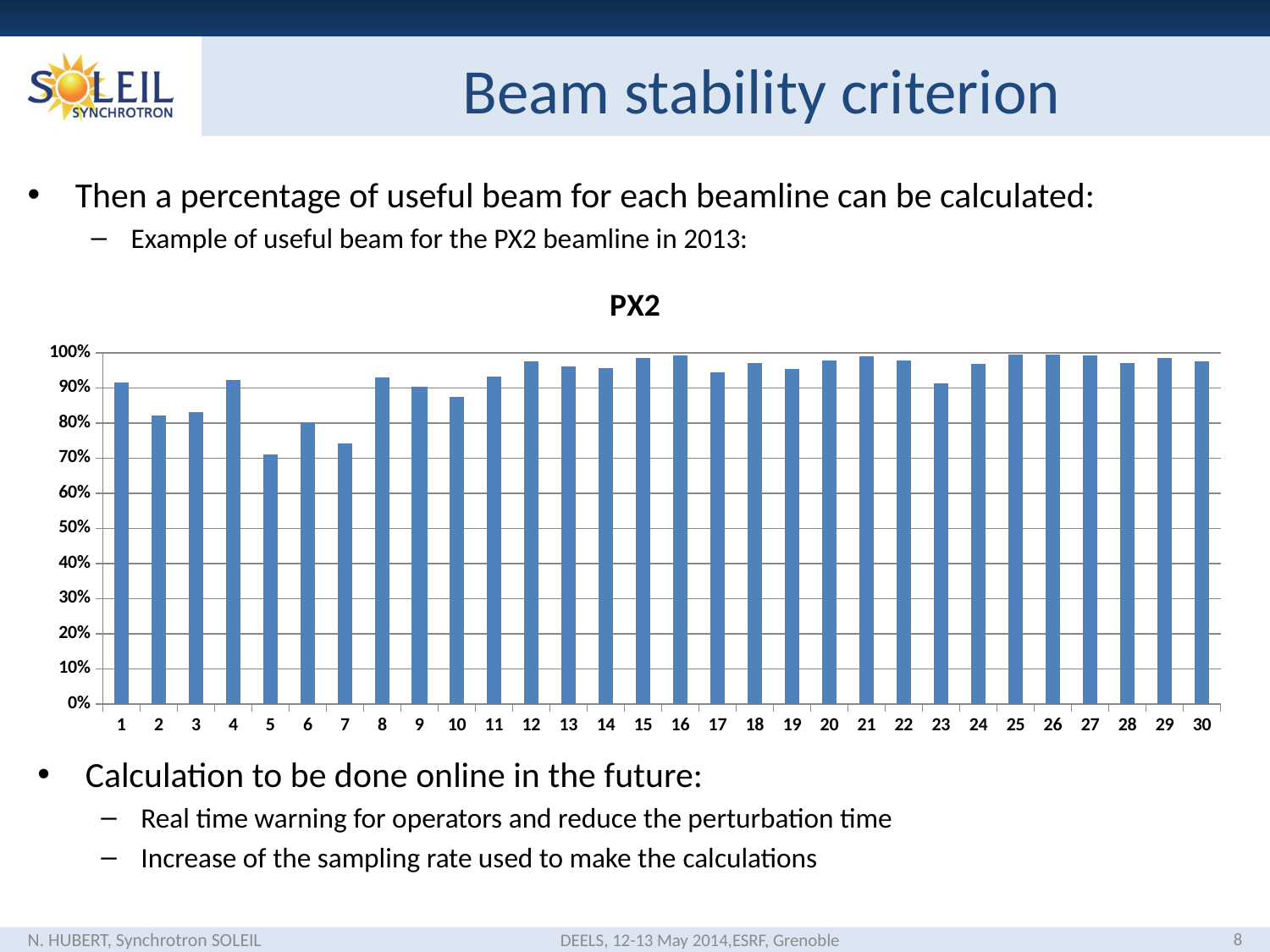
Which has the larger value, category 4 or category 5? 4 What kind of chart is shown on the slide? bar chart Which category has the lowest value in the chart? 5 What is the title of the chart? PX2 From category 10 to category 12, do the values rise or fall? rise How many categories are plotted along the x axis of the chart? 30 Is the value for category 12 greater or less than 90%? greater Is the value for category 10 greater or less than 90%? less Is the value for category 7 greater or less than 80%? less Which has the larger value, category 7 or category 8? 8